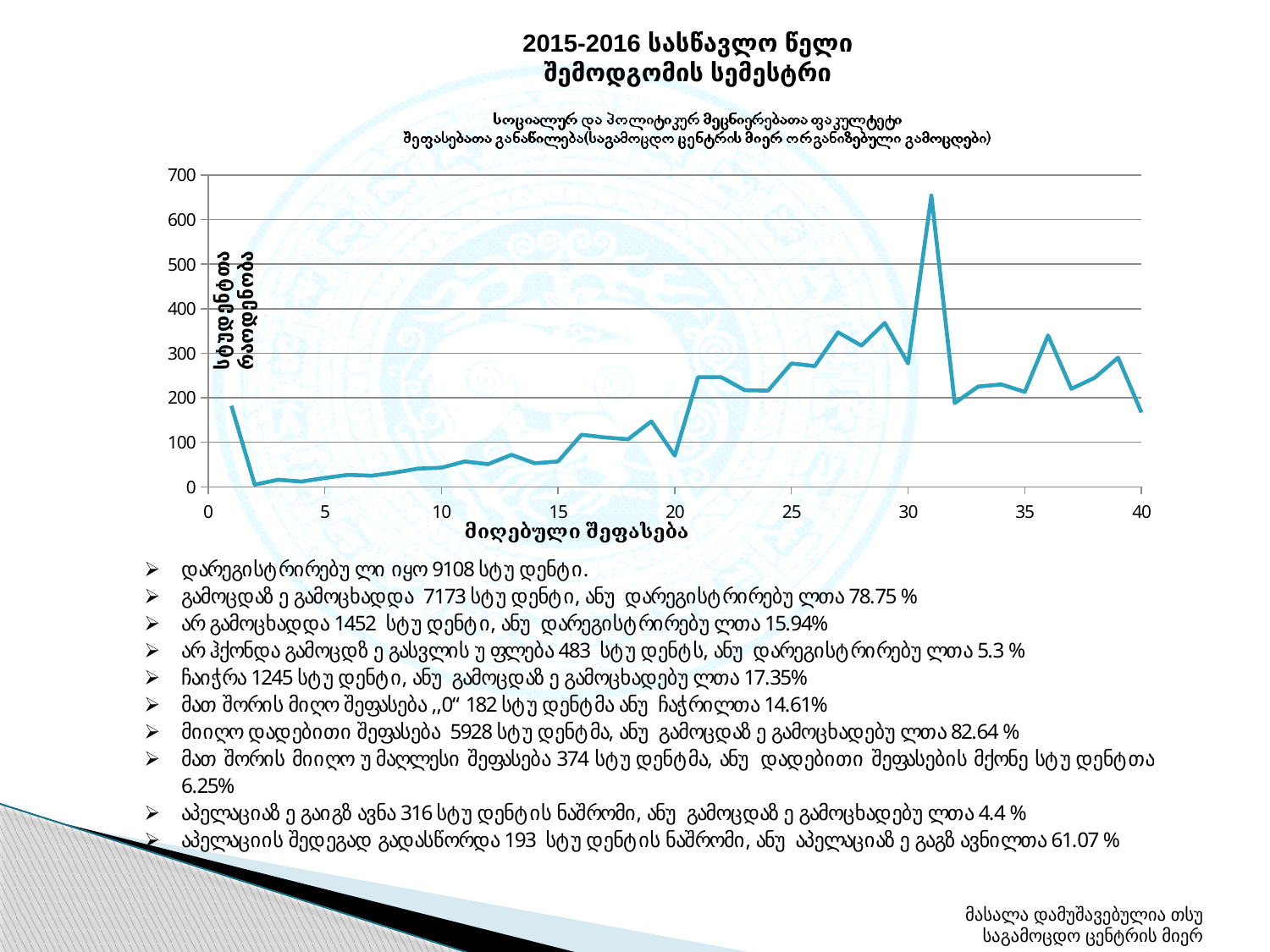
Do the values generally rise or fall along the x axis between x = 2 and x = 30? rise Is the value at x = 10 greater or less than 100? less Is the value at x = 25 greater or less than 200? greater What kind of chart is shown on the slide? line chart Is the value at x = 36 greater or less than 300? greater What is the highest value shown on the y axis? 700 At which x-axis value (მიღებული შეფასება) does the line reach its highest point? 31 What is the label of the x axis? მიღებული შეფასება Which is larger, the value at x = 31 or the value at x = 20? x = 31